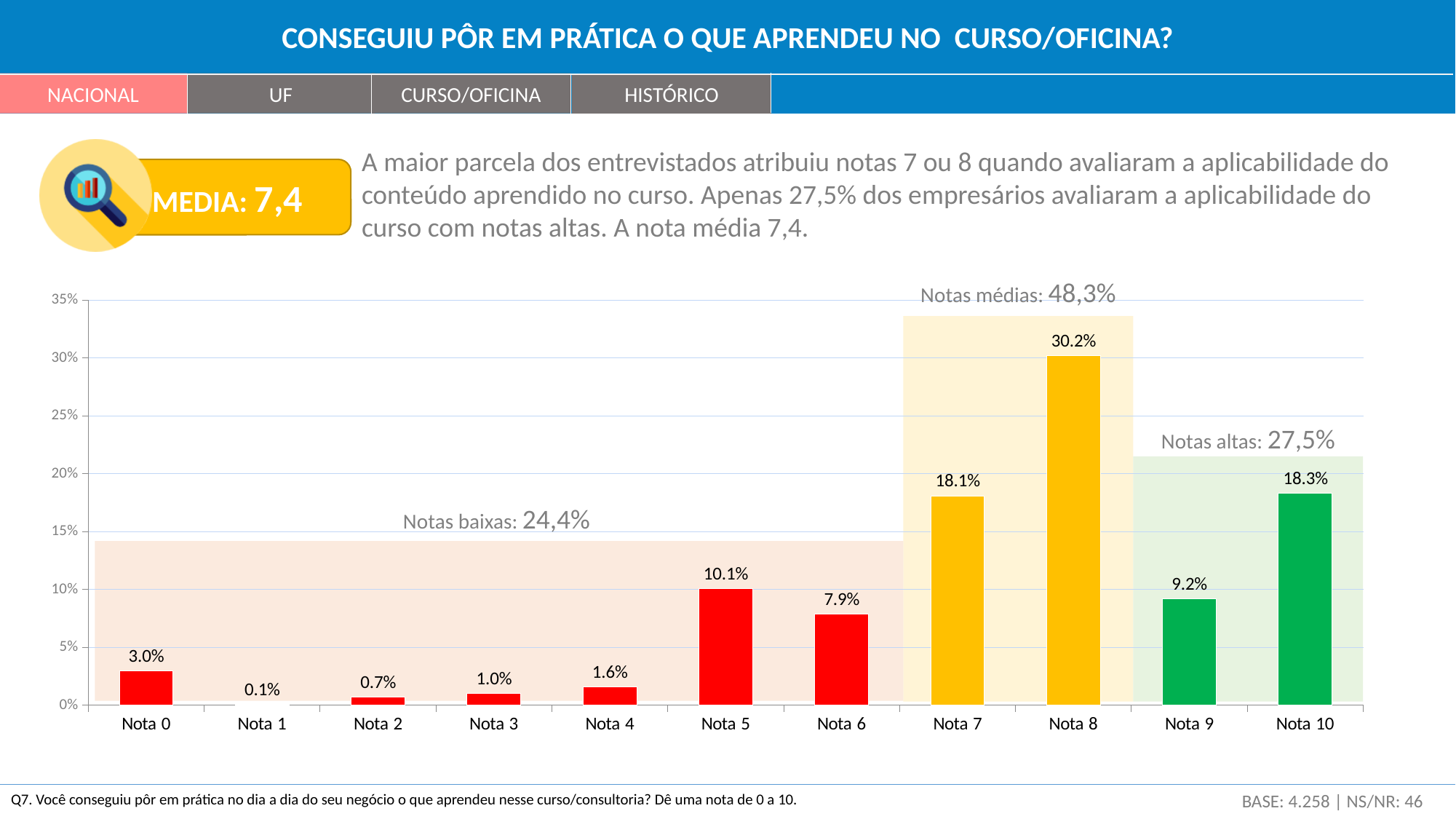
Is the value for Nota 7 greater or less than 15%? greater What is the value for Nota 5? 10.1% How many categories are shown on the x axis? 11 What is the difference between the values for Nota 8 and Nota 7? 12.1% What is the average score (MEDIA) shown on the slide? 7,4 What kind of chart is shown on the slide? bar chart What is the value for Nota 1? 0.1% Which category has the lowest value? Nota 1 What percentage is shown for 'Notas médias'? 48,3% Which is larger, the value for Nota 10 or the value for Nota 9? Nota 10 What is the value for Nota 8? 30.2% Which category has the highest value? Nota 8